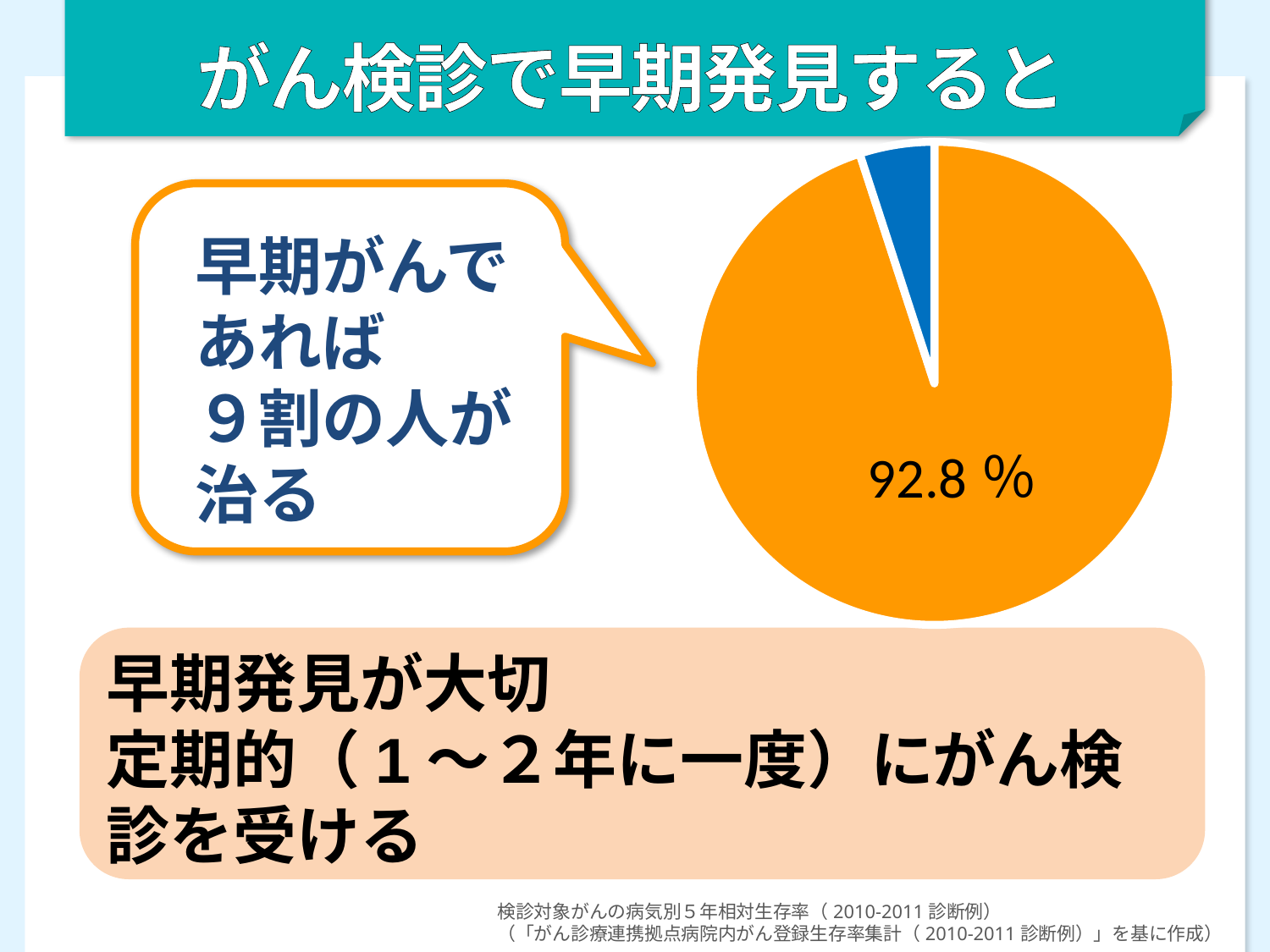
How many slices does the pie chart have? 2 What value is printed on the orange slice of the pie chart? 92.8 % Which slice of the pie chart is the smallest? the blue slice What kind of chart is shown on the slide? pie chart Which slice of the pie chart is larger, the orange one or the blue one? the orange one What colour is the largest slice of the pie chart? orange What share of the pie does the orange slice represent? 92.8 % Does the pie chart show a legend? no